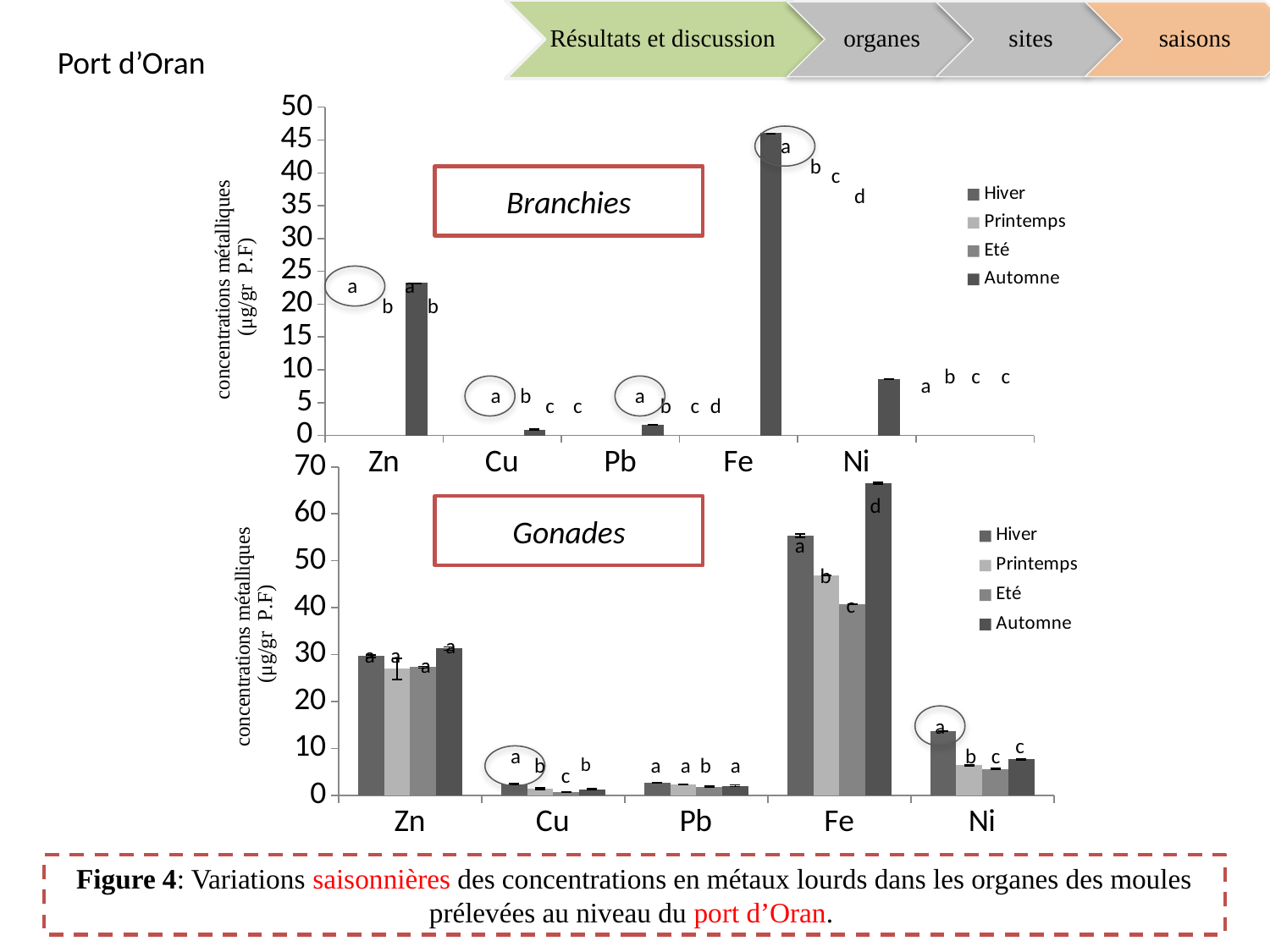
What kind of chart is the Branchies chart? bar chart In the Gonades chart, is the Automne value for Fe greater or less than 60? greater In the Gonades chart, which series has the highest value for Fe? Automne How many categories are shown on the x axis of the Gonades chart? 5 In the Gonades chart, is the Eté value for Fe greater or less than 50? less In the Gonades chart, which category has the highest bars? Fe How many series does the legend of the Gonades chart list? 4 In the Branchies chart, which category has the tallest bar? Fe In the Gonades chart, which is larger for Ni: the Hiver value or the Printemps value? Hiver What are the four legend entries of the Branchies chart? Hiver, Printemps, Eté, Automne